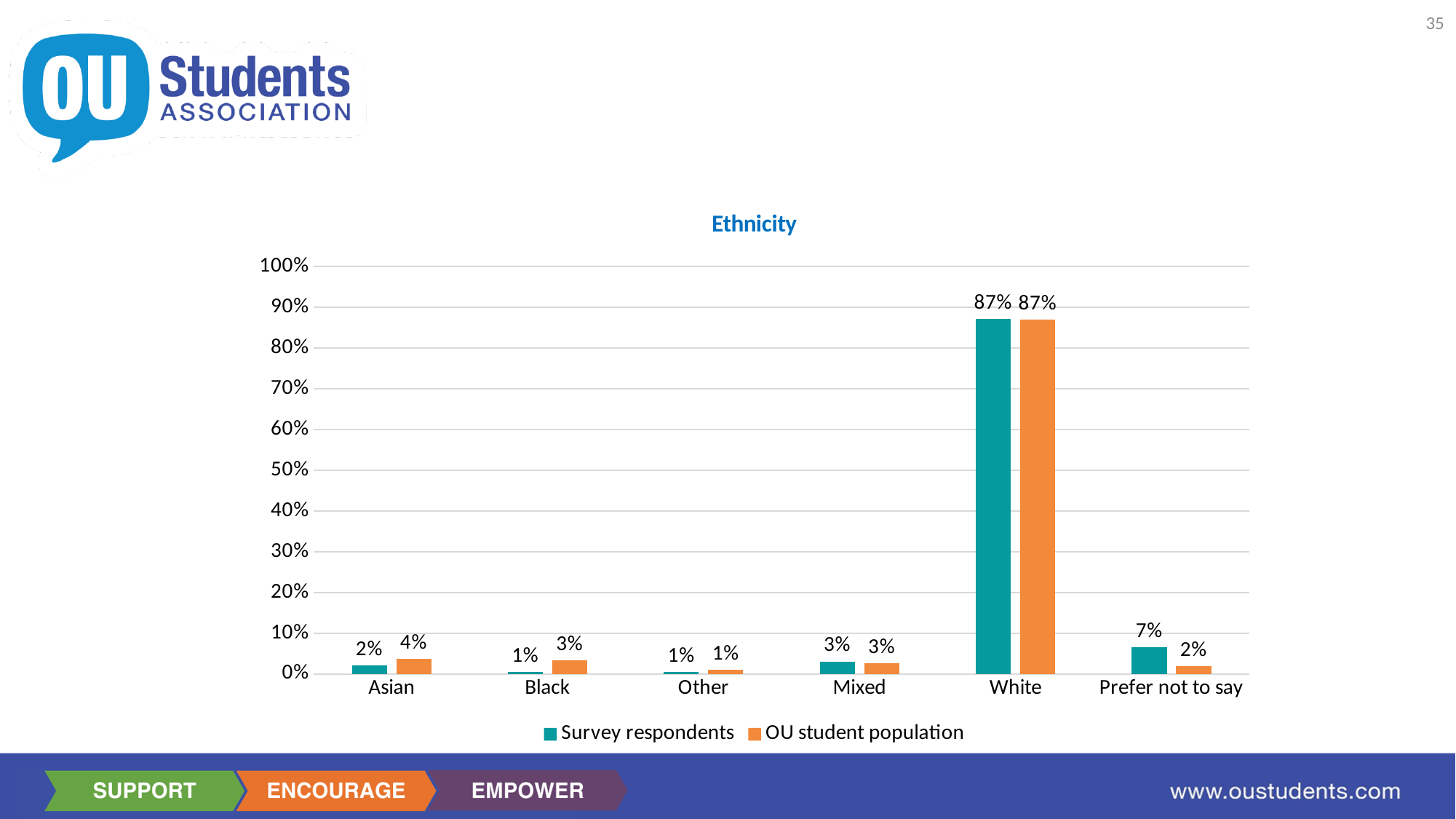
What is the Survey respondents value for White? 87% Which category has the lowest OU student population value? Other How many ethnicity categories are shown on the x axis? 6 What type of chart is shown? Bar chart How many series does the legend list? 2 Is the Survey respondents value for White greater or less than 80%? greater What is the OU student population value for Black? 3% What is the OU student population value for Asian? 4% What is the Survey respondents value for Prefer not to say? 7% Which category has the highest Survey respondents value? White For Asian, which is larger: Survey respondents or OU student population? OU student population What is the difference between the Survey respondents and OU student population values for Prefer not to say? 5%